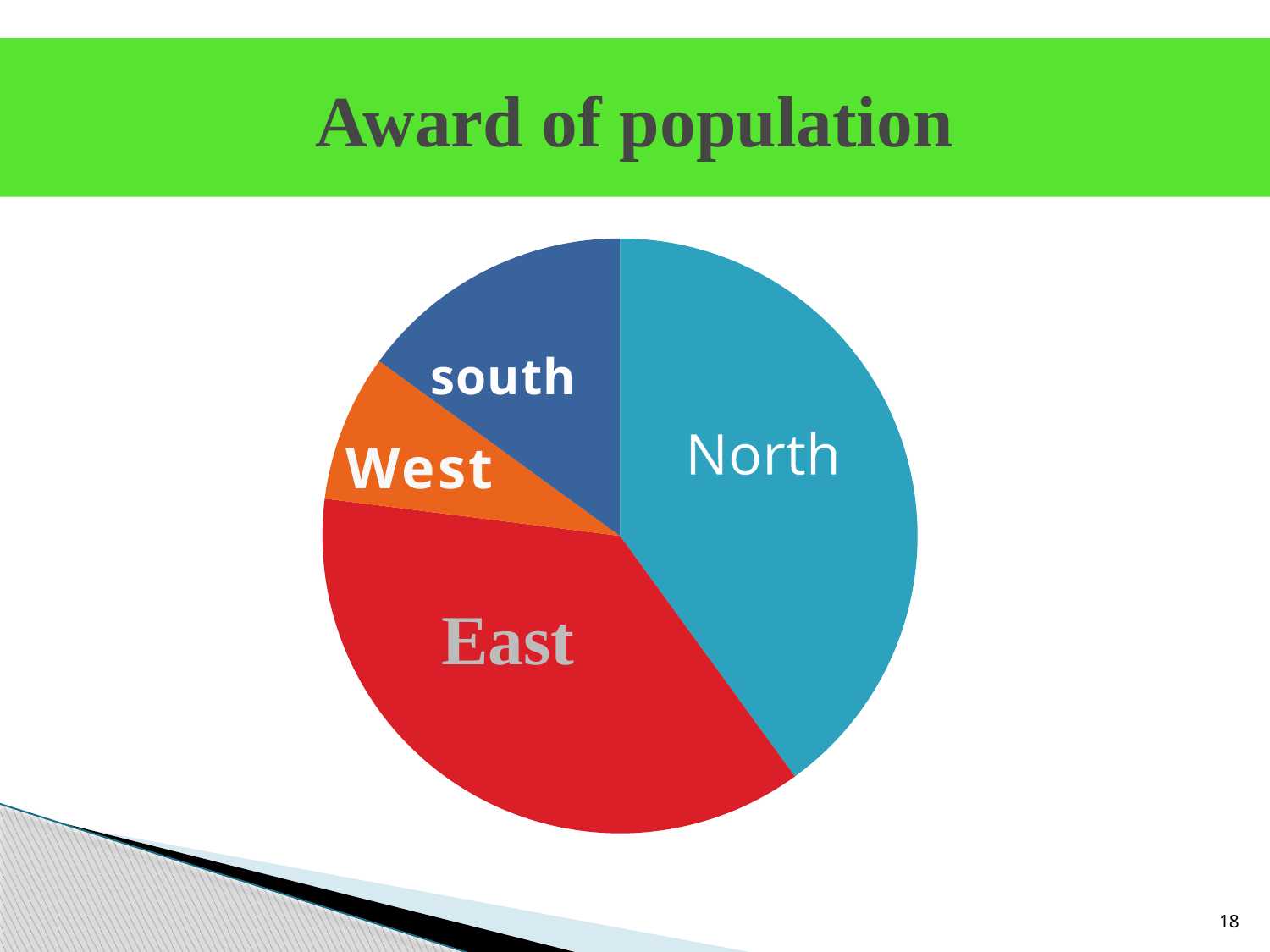
What kind of chart is shown on the slide? pie chart What is the title of the slide containing the pie chart? Award of population Which slice is larger, North or East? North Which slice of the pie chart is the largest? North How many slices does the pie chart have? 4 Which slice is larger, North or West? North Which slice is larger, south or West? south Which slice of the pie chart is the smallest? West What colour is the East slice of the pie chart? red